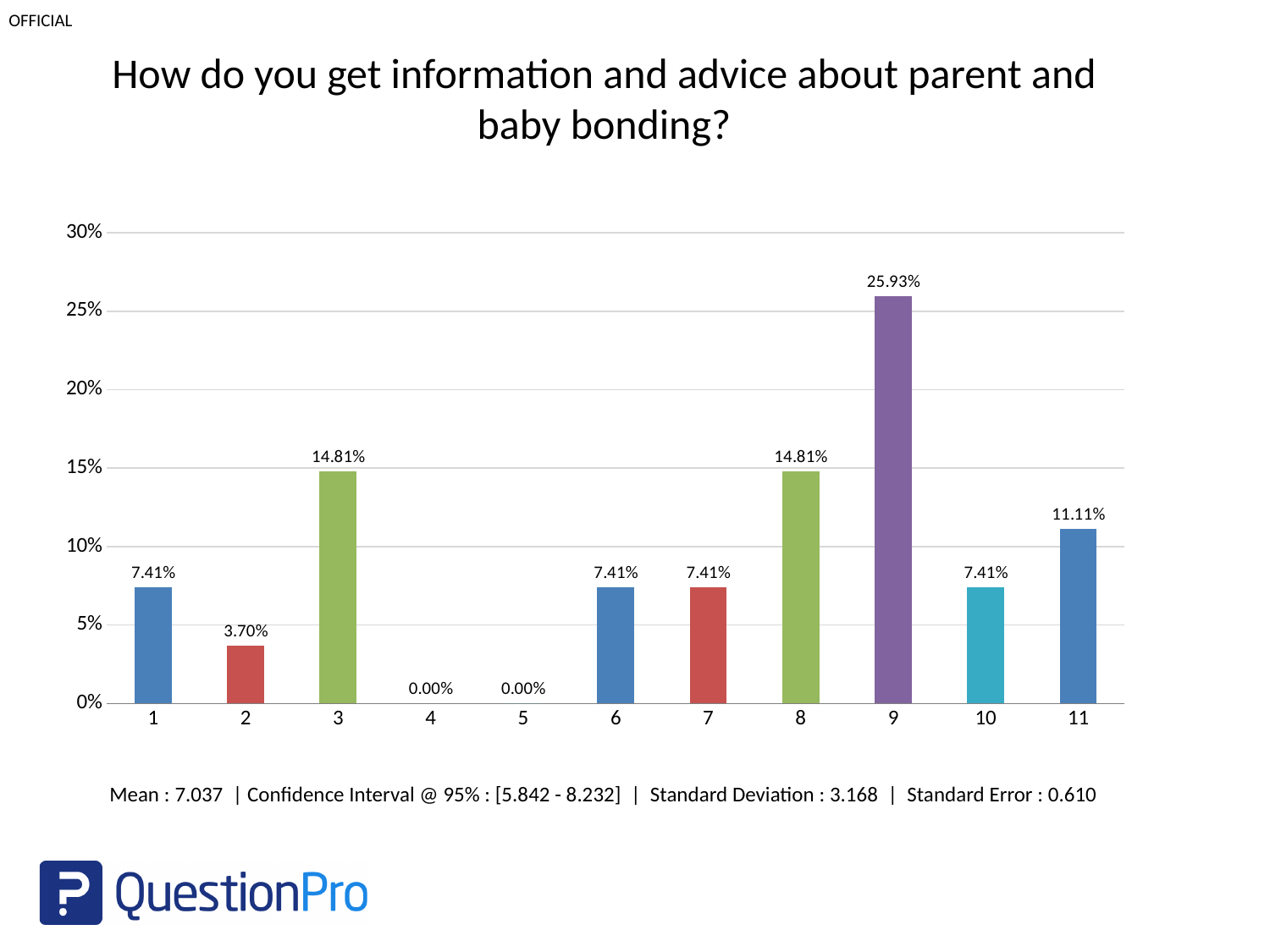
What kind of chart is shown on the slide? Bar chart Is the value for category 9 greater or less than 20%? greater What is the difference between the values for category 9 and category 11? 14.82% Which categories have a value of 0.00%? 4 and 5 Which is larger, the value for category 3 or the value for category 10? Category 3 Which category has the highest value? 9 How many categories are shown on the x axis? 11 What is the value for category 2? 3.70% What is the title of the chart? How do you get information and advice about parent and baby bonding? What is the value for category 11? 11.11% What is the value for category 9? 25.93% How many categories have a value of 7.41%? 4